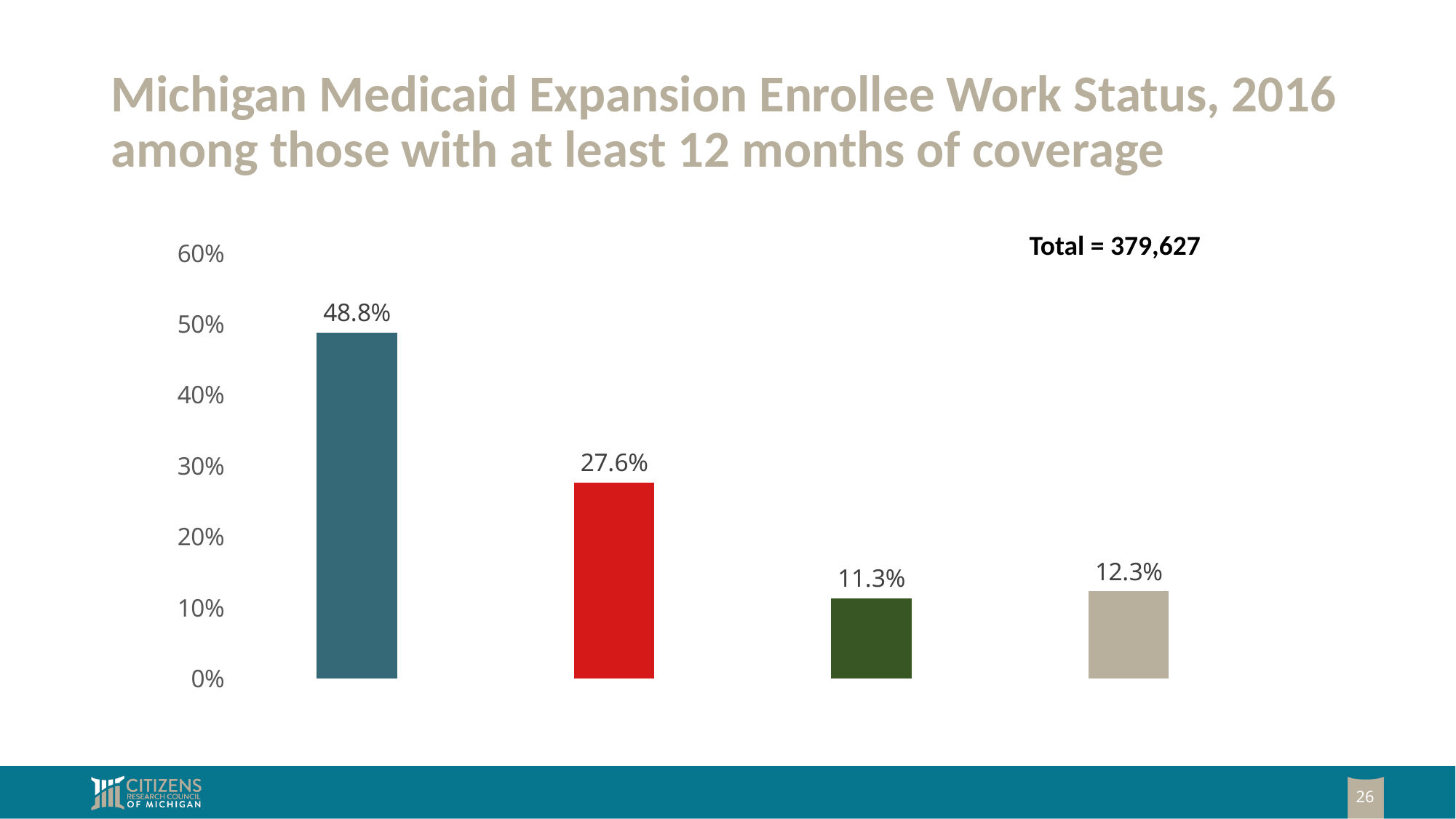
Which bar has the highest value? the first (blue) bar, 48.8% What is the difference between the first bar (48.8%) and the second bar (27.6%)? 21.2% What is the highest value shown on the vertical axis? 60% What is the value shown on the first (leftmost, blue) bar? 48.8% What is the value shown on the second (red) bar? 27.6% What is the value shown on the third (green) bar? 11.3% Which bar has the lowest value? the third (green) bar, 11.3% How many bars are plotted in the chart? 4 What total number of enrollees is stated on the chart? 379,627 What is the value shown on the fourth (rightmost, tan) bar? 12.3% Which is larger, the third bar or the fourth bar? the fourth bar (12.3%) What type of chart is shown on the slide? bar chart